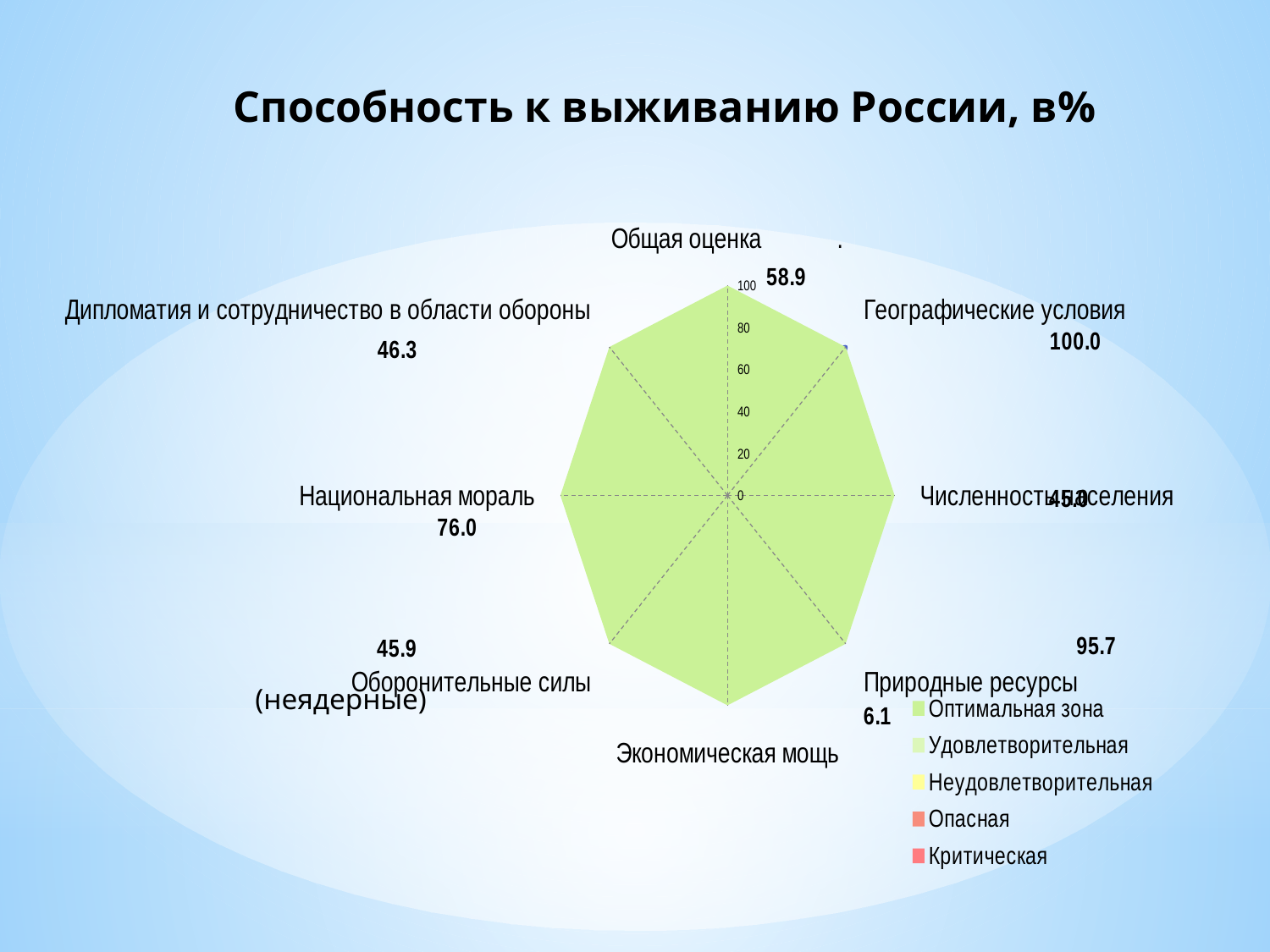
Which category has the highest value? Географические условия What is the title of the chart on the slide? Способность к выживанию России, в% What is the value shown for Экономическая мощь? 6.1 What is the value shown for Национальная мораль? 76.0 How many categories (axes) does the radar chart have? 8 Which category has the lowest value? Экономическая мощь What type of chart is shown on the slide? Radar chart What is the value shown for Географические условия? 100.0 How many entries does the legend list? 5 Which is larger, the value for Дипломатия и сотрудничество в области обороны or the value for Оборонительные силы (неядерные)? Дипломатия и сотрудничество в области обороны What is the difference between the values for Природные ресурсы and Национальная мораль? 19.7 What is the value shown for Общая оценка? 58.9